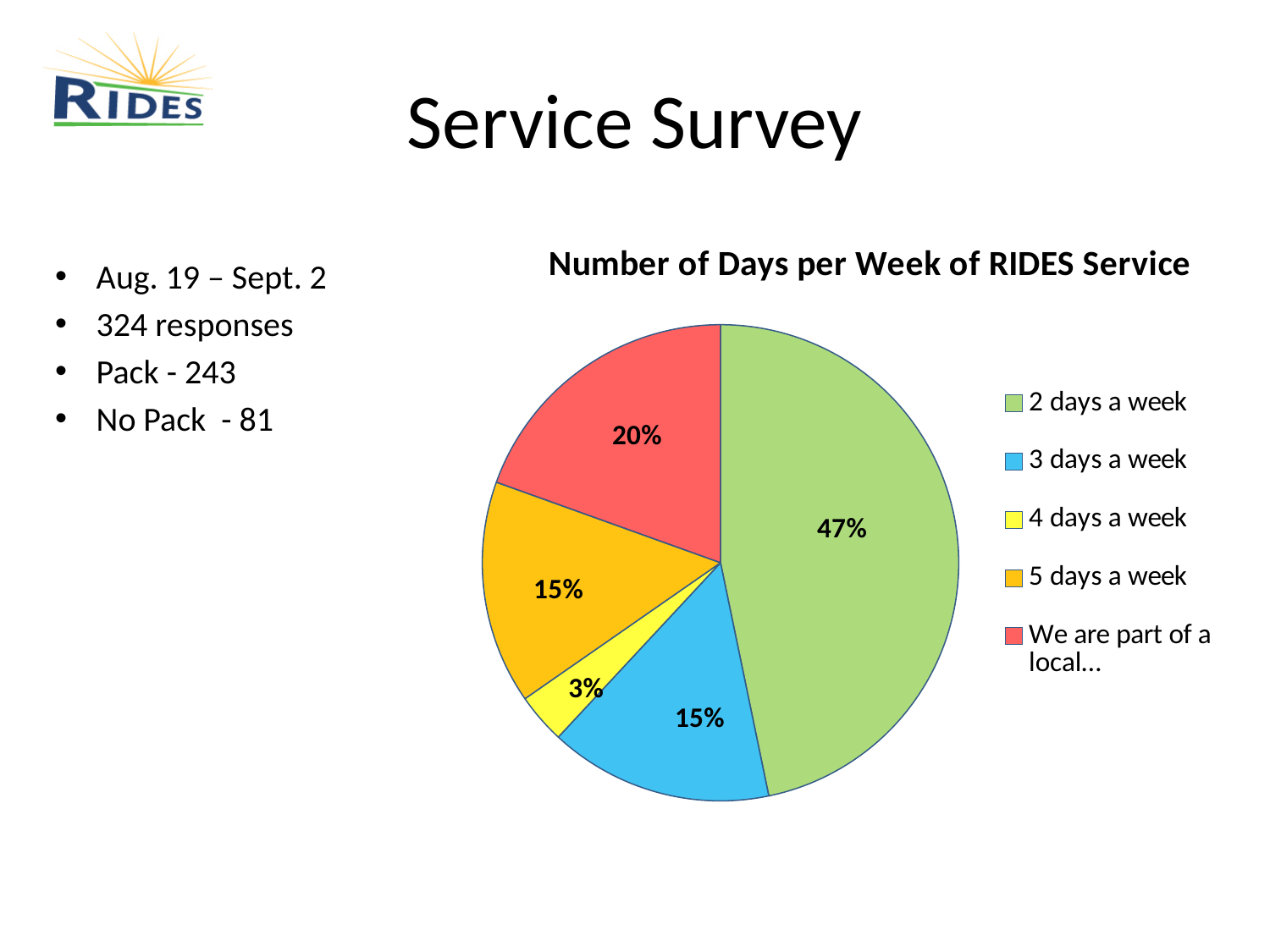
What is the title of the chart? Number of Days per Week of RIDES Service Which slice is larger: "2 days a week" or "We are part of a local…"? 2 days a week How many slices does the pie chart have? 5 What type of chart is shown on the slide? Pie chart Which category has the largest slice of the pie? 2 days a week What percentage of the pie is the "2 days a week" slice? 47% Which category has the smallest slice of the pie? 4 days a week What percentage does the "3 days a week" slice show? 15% What percentage does the "5 days a week" slice show? 15% What percentage does the red slice labelled "We are part of a local…" show? 20% What percentage does the "4 days a week" slice show? 3% How many percentage points larger is the "2 days a week" slice than the "3 days a week" slice? 32%